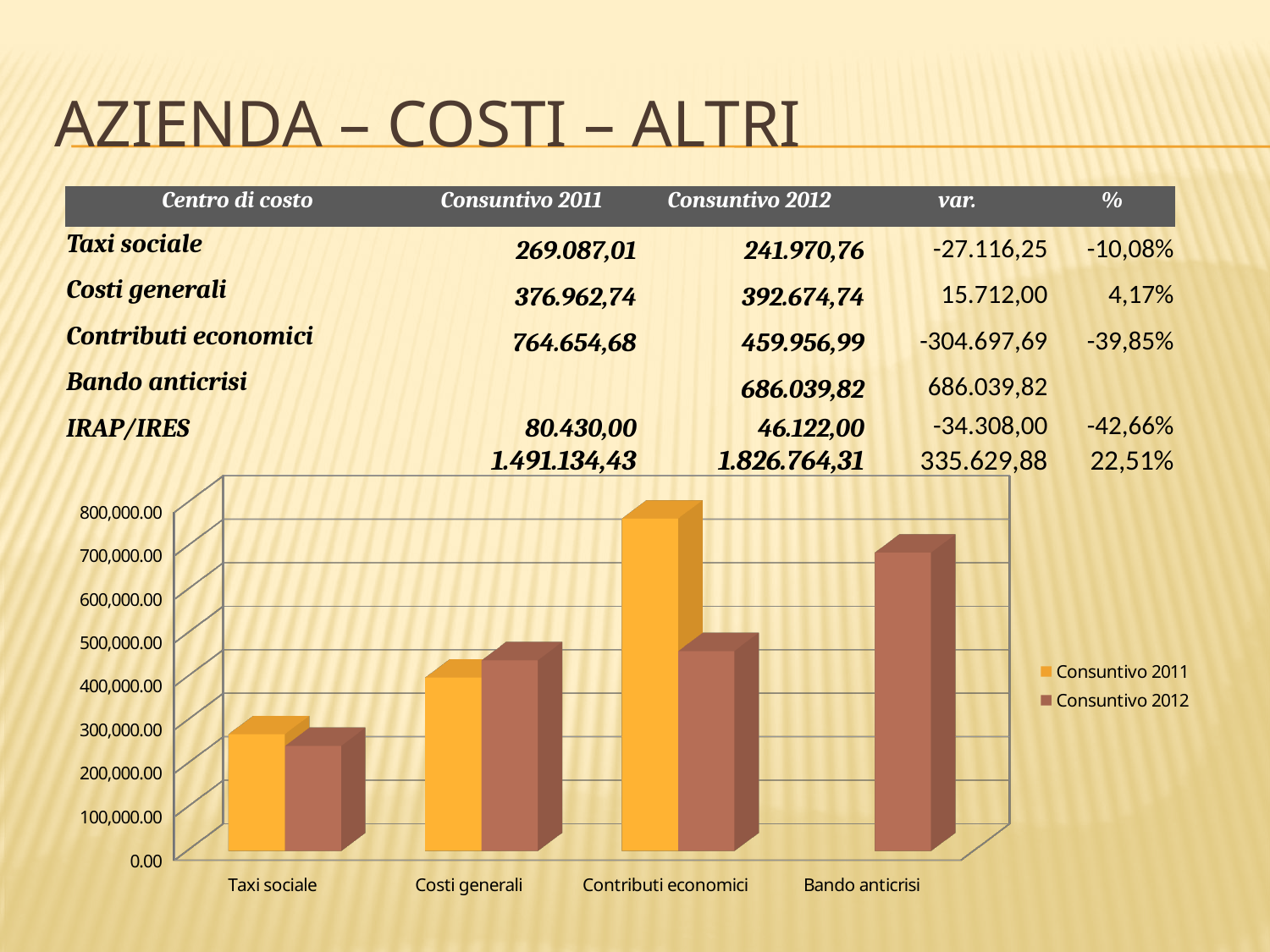
Is the Consuntivo 2011 value for Contributi economici greater or less than 700,000.00? greater How many series does the chart legend list? 2 Is the Consuntivo 2011 value for Taxi sociale greater or less than 300,000.00? less What kind of chart is shown on the slide? bar chart Which category has no Consuntivo 2011 bar in the chart? Bando anticrisi Which category has the highest Consuntivo 2011 bar? Contributi economici For Contributi economici, which is larger: Consuntivo 2011 or Consuntivo 2012? Consuntivo 2011 How many categories are shown on the x axis of the chart? 4 Which category has the highest Consuntivo 2012 bar? Bando anticrisi Which category has the lowest Consuntivo 2012 bar? Taxi sociale Is the Consuntivo 2012 value for Contributi economici greater or less than 500,000.00? less